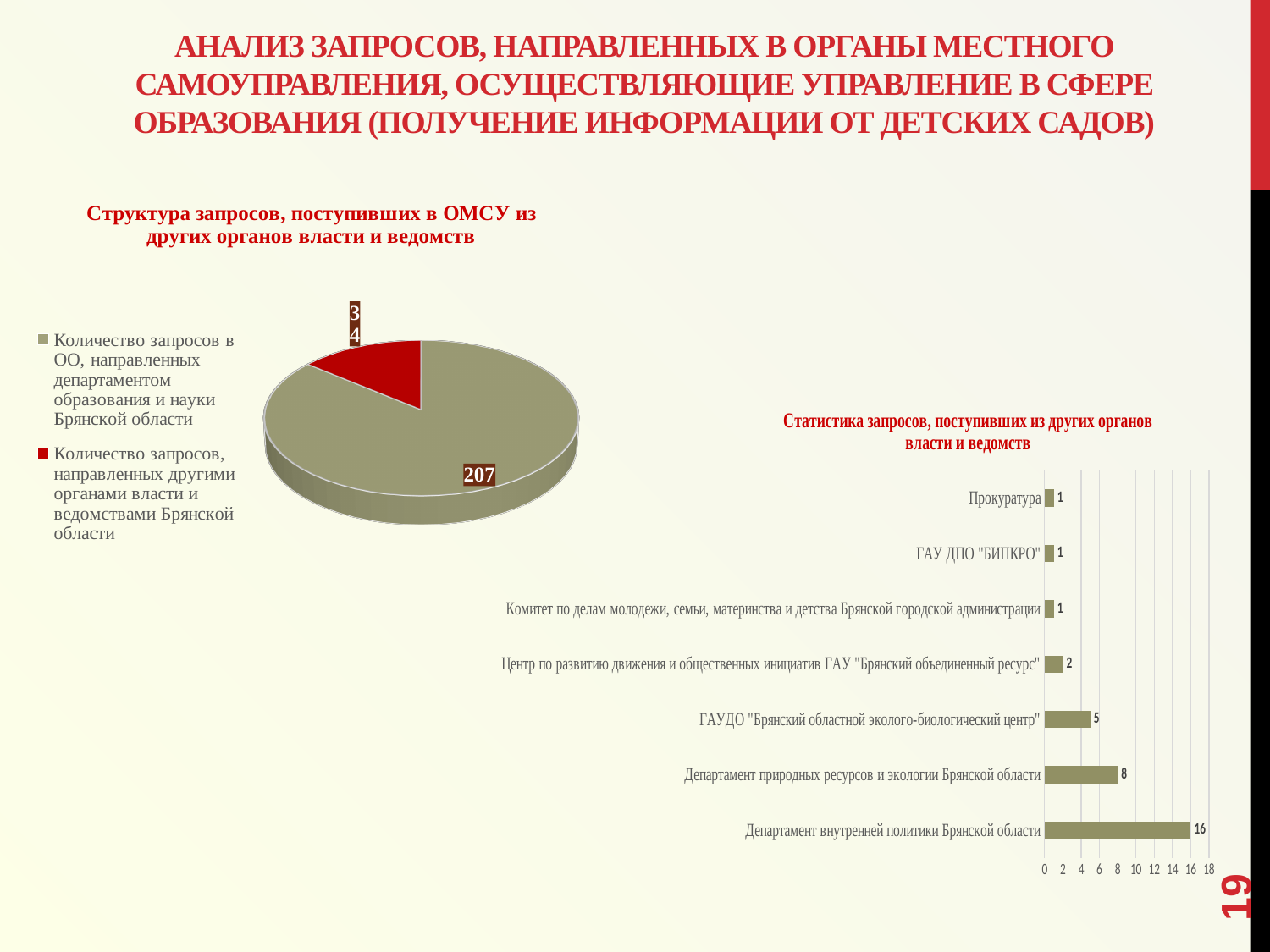
In the bar chart on the right, how many categories are shown? 7 In the bar chart on the right, what is the value for "Прокуратура"? 1 In the bar chart on the right, which category has the highest value? Департамент внутренней политики Брянской области In the bar chart on the right, what is the difference between the values for "Департамент внутренней политики Брянской области" and "Департамент природных ресурсов и экологии Брянской области"? 8 What type of chart is the chart titled "Структура запросов, поступивших в ОМСУ из других органов власти и ведомств"? pie chart How many entries does the legend of the pie chart on the left list? 2 In the pie chart on the left, what is the value for "Количество запросов, направленных другими органами власти и ведомствами Брянской области"? 34 What type of chart is the chart titled "Статистика запросов, поступивших из других органов власти и ведомств"? bar chart In the pie chart on the left, what is the value for "Количество запросов в ОО, направленных департаментом образования и науки Брянской области"? 207 In the bar chart on the right, what is the value for "ГАУДО "Брянский областной эколого-биологический центр""? 5 In the bar chart on the right, what is the value for "Департамент природных ресурсов и экологии Брянской области"? 8 In the pie chart on the left, which slice is larger: the one for requests sent by the department of education and science, or the one for requests sent by other authorities? Количество запросов в ОО, направленных департаментом образования и науки Брянской области